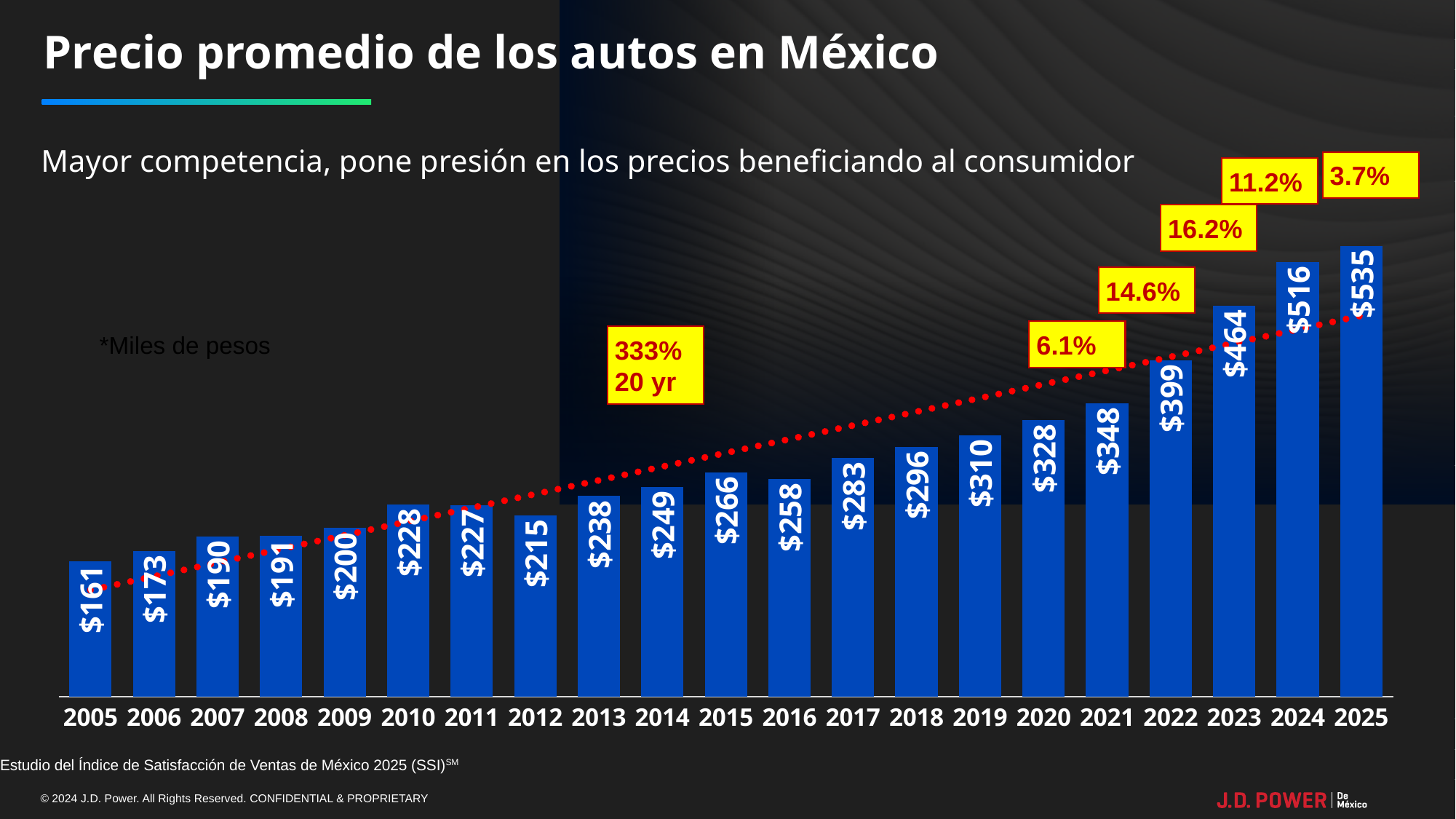
What is the average car price shown for 2025? $535 What kind of chart is shown on the slide? Bar chart What is the difference between the values for 2025 and 2005? $374 Which year has the highest average price? 2025 What is the value shown for 2012? $215 What is the value shown for 2020? $328 Which year has the lowest average price? 2005 What is the title of the chart on the slide? Precio promedio de los autos en México How many years are shown on the x axis? 21 What is the difference between the values for 2024 and 2023? $52 Which is larger, the value for 2015 or the value for 2016? 2015 Do the values generally rise or fall from 2005 to 2025? Rise